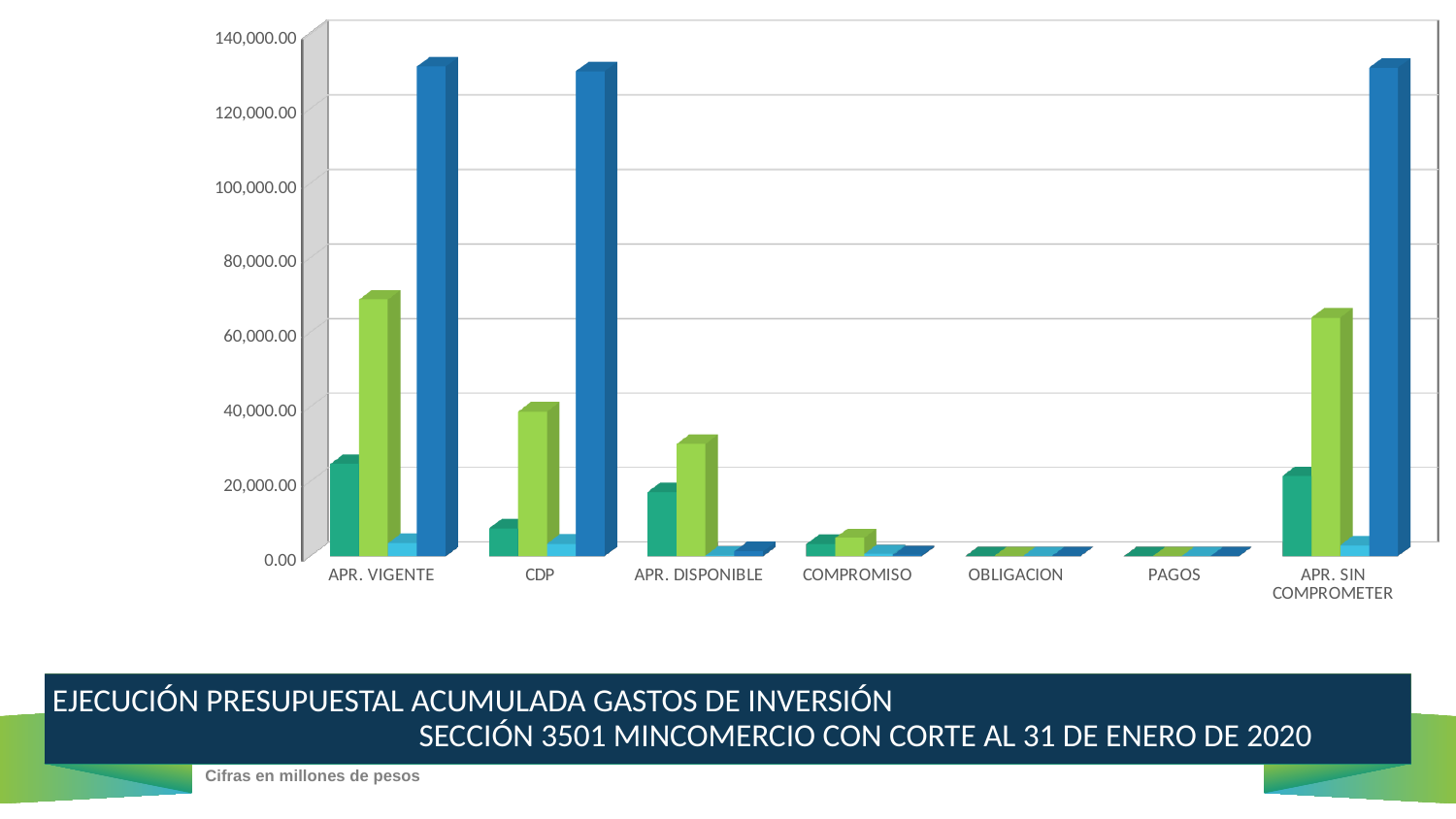
Is the value of the green bar for APR. DISPONIBLE greater or less than 40,000.00? less What kind of chart is shown on the slide? Bar chart How many categories are shown on the x axis of the chart? 7 Is the value of the green bar for CDP greater or less than 60,000.00? less Is the value of the dark blue bar for APR. VIGENTE greater or less than 120,000.00? greater According to the note below the chart, in what units are the figures expressed? Millones de pesos What is the highest value shown on the vertical axis of the chart? 140,000.00 How many bars are plotted for each category in the chart? 4 Which is larger, the green bar for APR. VIGENTE or the green bar for CDP? APR. VIGENTE Which is larger, the dark blue bar for CDP or the dark blue bar for COMPROMISO? CDP